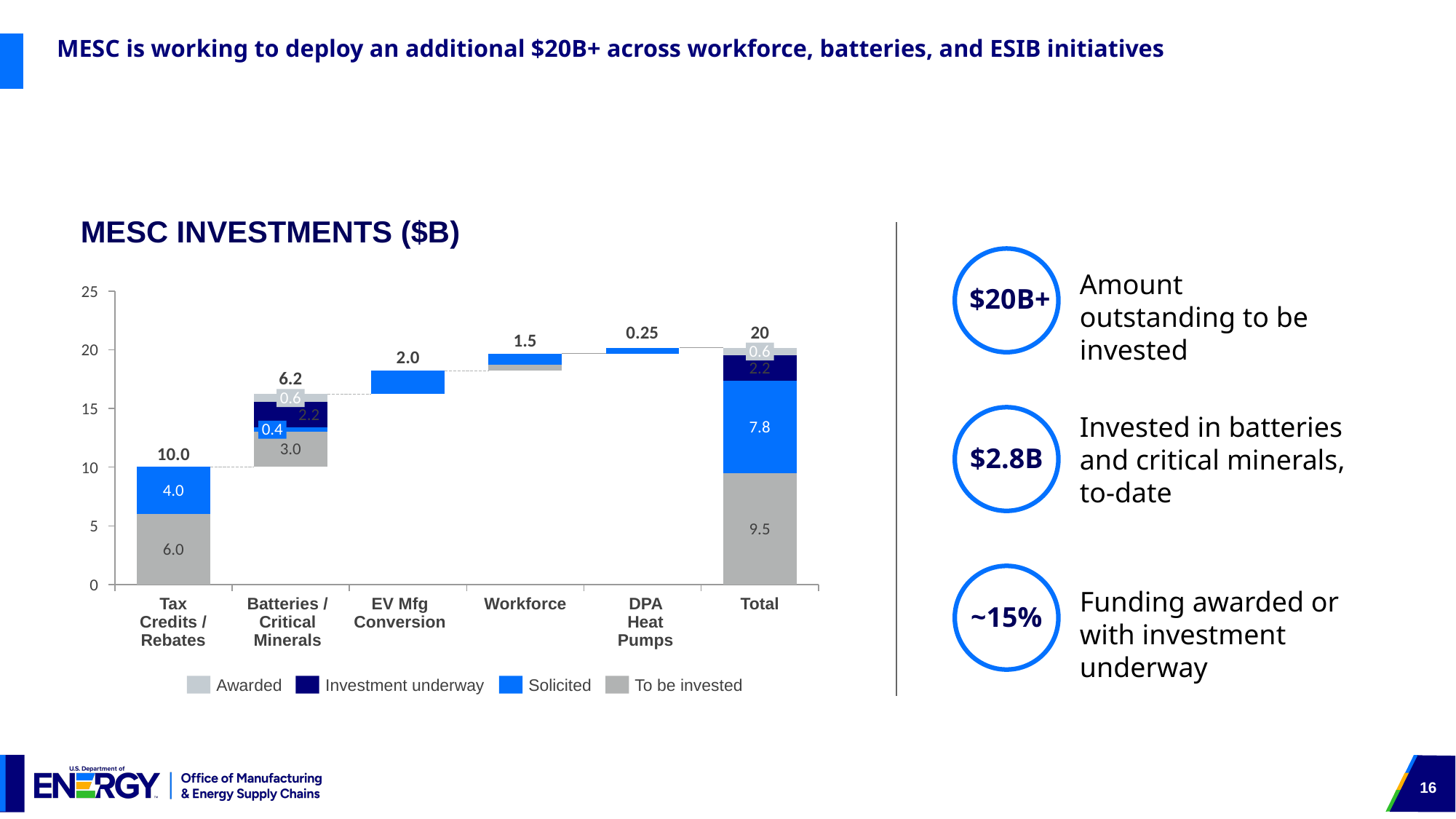
What is the total value shown for the Tax Credits / Rebates bar? 10.0 Excluding the Total bar, which category has the lowest labelled value? DPA Heat Pumps What is the To be invested value within the Tax Credits / Rebates bar? 6.0 How many series does the legend list? 4 What is the difference between the labelled values for Tax Credits / Rebates and Batteries / Critical Minerals? 3.8 Which has a larger labelled value, EV Mfg Conversion or Workforce? EV Mfg Conversion What is the value labelled for DPA Heat Pumps? 0.25 What is the value labelled for the Batteries / Critical Minerals bar? 6.2 What is the Solicited value within the Total bar? 7.8 Excluding the Total bar, which category has the highest labelled value? Tax Credits / Rebates How many categories are shown on the x axis, including Total? 6 What kind of chart is shown on the slide? Bar chart